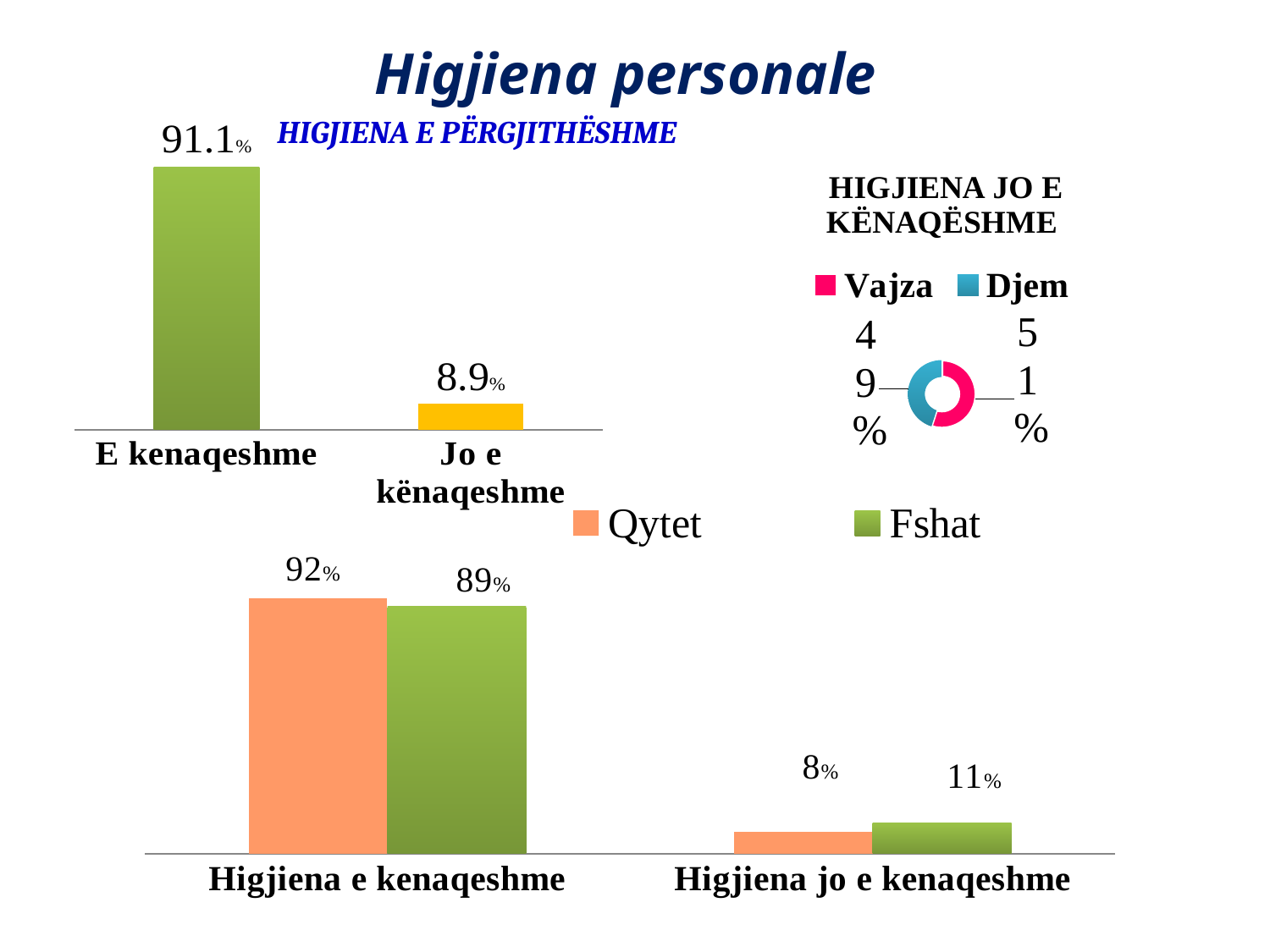
In the chart titled HIGJIENA E PËRGJITHËSHME, what is the difference between E kenaqeshme and Jo e kënaqeshme? 82.2% In the chart titled HIGJIENA E PËRGJITHËSHME, which category has the highest value? E kenaqeshme In the chart titled HIGJIENA JO E KËNAQËSHME, what are the two legend entries? Vajza and Djem In the chart titled HIGJIENA E PËRGJITHËSHME, what is the value for Jo e kënaqeshme? 8.9% In the bottom chart, what is the Fshat value for Higjiena jo e kenaqeshme? 11% In the bottom chart, which is larger for Higjiena jo e kenaqeshme: Qytet or Fshat? Fshat In the chart titled HIGJIENA JO E KËNAQËSHME, how many series does the legend list? 2 In the bottom chart, how many categories are shown on the x axis? 2 In the chart titled HIGJIENA E PËRGJITHËSHME, what is the value for E kenaqeshme? 91.1% In the bottom chart, what is the Qytet value for Higjiena e kenaqeshme? 92% What kind of chart is the chart titled HIGJIENA JO E KËNAQËSHME? Doughnut (pie) chart In the bottom chart, what is the difference between the Qytet and Fshat values for Higjiena e kenaqeshme? 3%